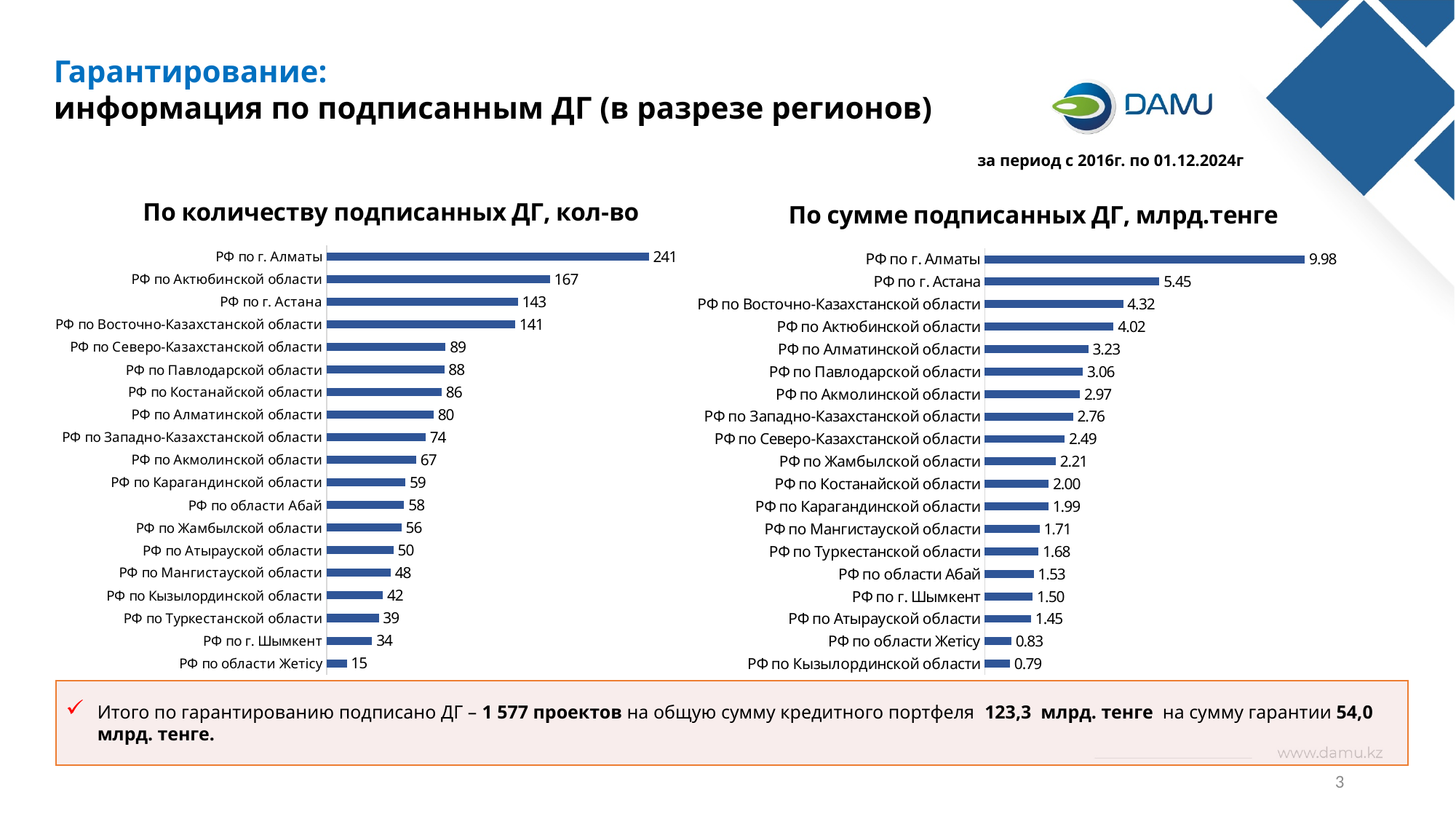
In the chart 'По количеству подписанных ДГ, кол-во', what is the value for РФ по Павлодарской области? 88 In the chart 'По сумме подписанных ДГ, млрд.тенге', what is the value for РФ по г. Астана? 5.45 In the chart 'По количеству подписанных ДГ, кол-во', which category has the lowest value? РФ по области Жетісу In the chart 'По сумме подписанных ДГ, млрд.тенге', which category has the highest value? РФ по г. Алматы In the chart 'По сумме подписанных ДГ, млрд.тенге', what is the value for РФ по Мангистауской области? 1.71 In the chart 'По сумме подписанных ДГ, млрд.тенге', which category has the lowest value? РФ по Кызылординской области In the chart 'По количеству подписанных ДГ, кол-во', what is the difference between РФ по Актюбинской области and РФ по г. Астана? 24 In the chart 'По количеству подписанных ДГ, кол-во', what is the value for РФ по г. Алматы? 241 In the chart 'По количеству подписанных ДГ, кол-во', how many categories are shown? 19 What type of chart is 'По количеству подписанных ДГ, кол-во'? Bar chart In the chart 'По сумме подписанных ДГ, млрд.тенге', which is larger: РФ по Восточно-Казахстанской области or РФ по Алматинской области? РФ по Восточно-Казахстанской области In the chart 'По сумме подписанных ДГ, млрд.тенге', what is the difference between РФ по г. Алматы and РФ по г. Астана? 4.53